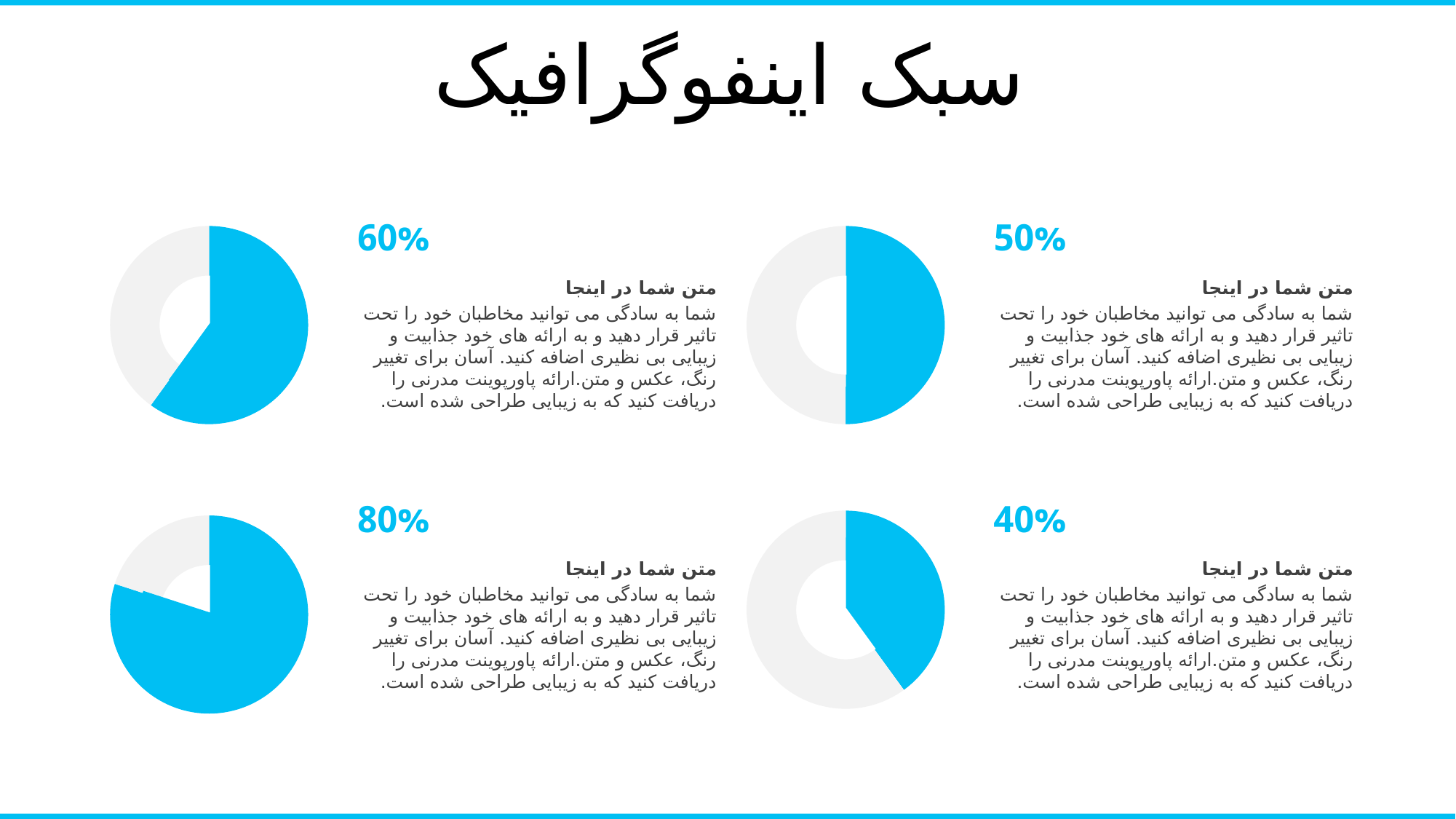
In the top-left chart, what percentage does the blue slice represent? 60% In the bottom-right chart, what percentage does the blue slice represent? 40% What is the difference between the percentage shown in the bottom-left chart and the percentage shown in the bottom-right chart? 40% Which of the four charts shows the largest blue share? The bottom-left chart (80%) In the top-right chart, is the blue slice greater or less than half of the pie? Exactly half (50%) Which of the four charts shows the smallest blue share? The bottom-right chart (40%) Which chart shows a larger percentage, the top-left chart or the top-right chart? The top-left chart How many charts are on the slide? 4 In the top-right chart, what percentage does the blue slice represent? 50% What kind of chart is used on this slide? Pie chart What colour is the highlighted slice in each chart? Blue In the bottom-left chart, what percentage does the blue slice represent? 80%